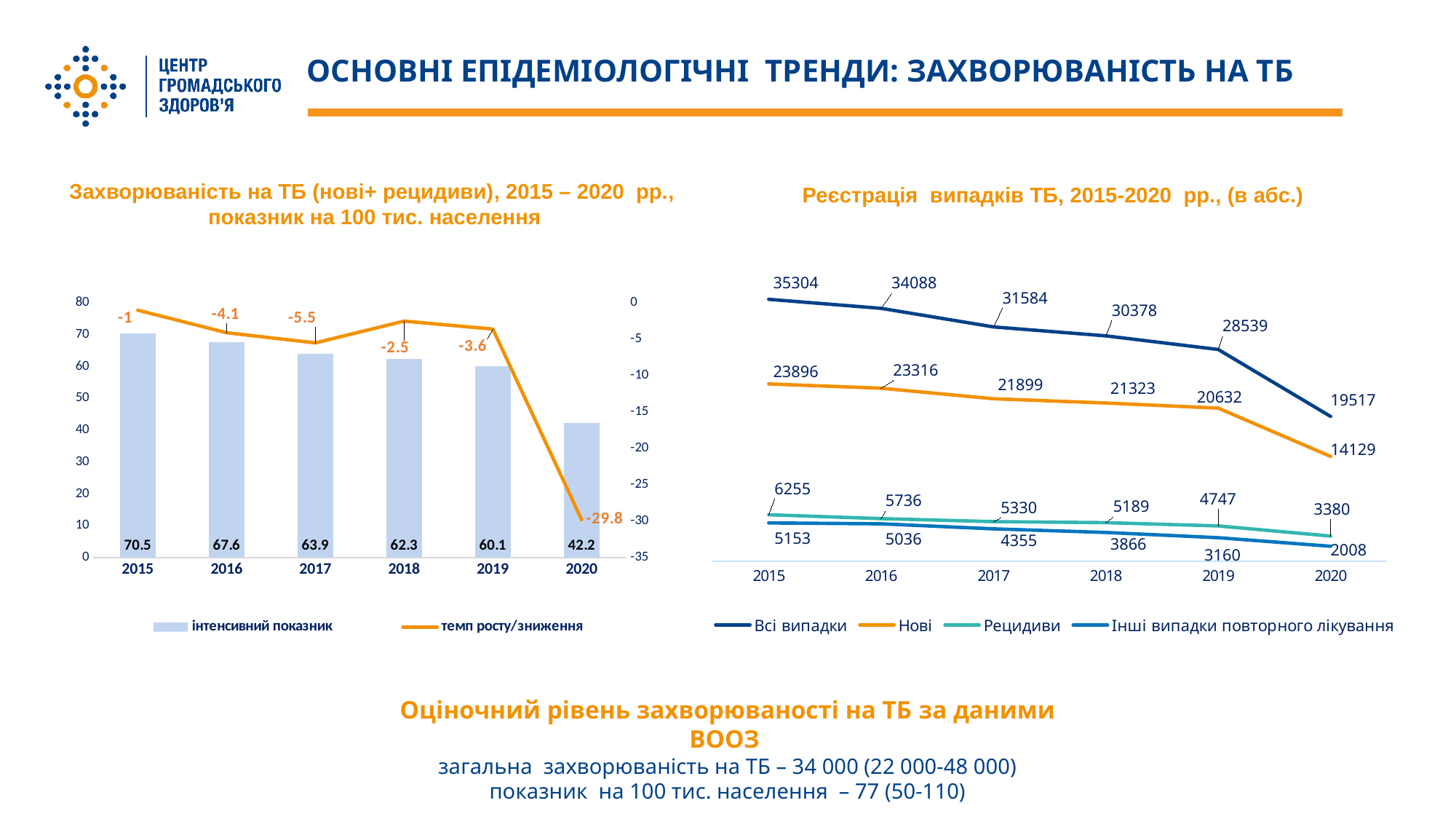
In the right chart (Реєстрація випадків ТБ), how many series does the legend list? 4 In the right chart (Реєстрація випадків ТБ), what is the difference between Всі випадки in 2015 and in 2020? 15787 What kind of chart is the right chart (Реєстрація випадків ТБ)? line chart In the left chart (Захворюваність на ТБ), do the інтенсивний показник bars rise or fall from 2015 to 2020? fall In the left chart (Захворюваність на ТБ), what is the difference between the інтенсивний показник values for 2015 and 2020? 28.3 In the right chart (Реєстрація випадків ТБ), what is the value for Всі випадки in 2019? 28539 In the left chart (Захворюваність на ТБ), how many series does the legend list? 2 In the left chart (Захворюваність на ТБ), what is the темп росту/зниження value for 2017? -5.5 In the right chart (Реєстрація випадків ТБ), what is the value for Нові in 2020? 14129 In the left chart (Захворюваність на ТБ), what is the value of the інтенсивний показник bar for 2020? 42.2 In the right chart (Реєстрація випадків ТБ), which is larger in 2018: Рецидиви or Інші випадки повторного лікування? Рецидиви In the left chart (Захворюваність на ТБ), which year has the highest інтенсивний показник bar? 2015